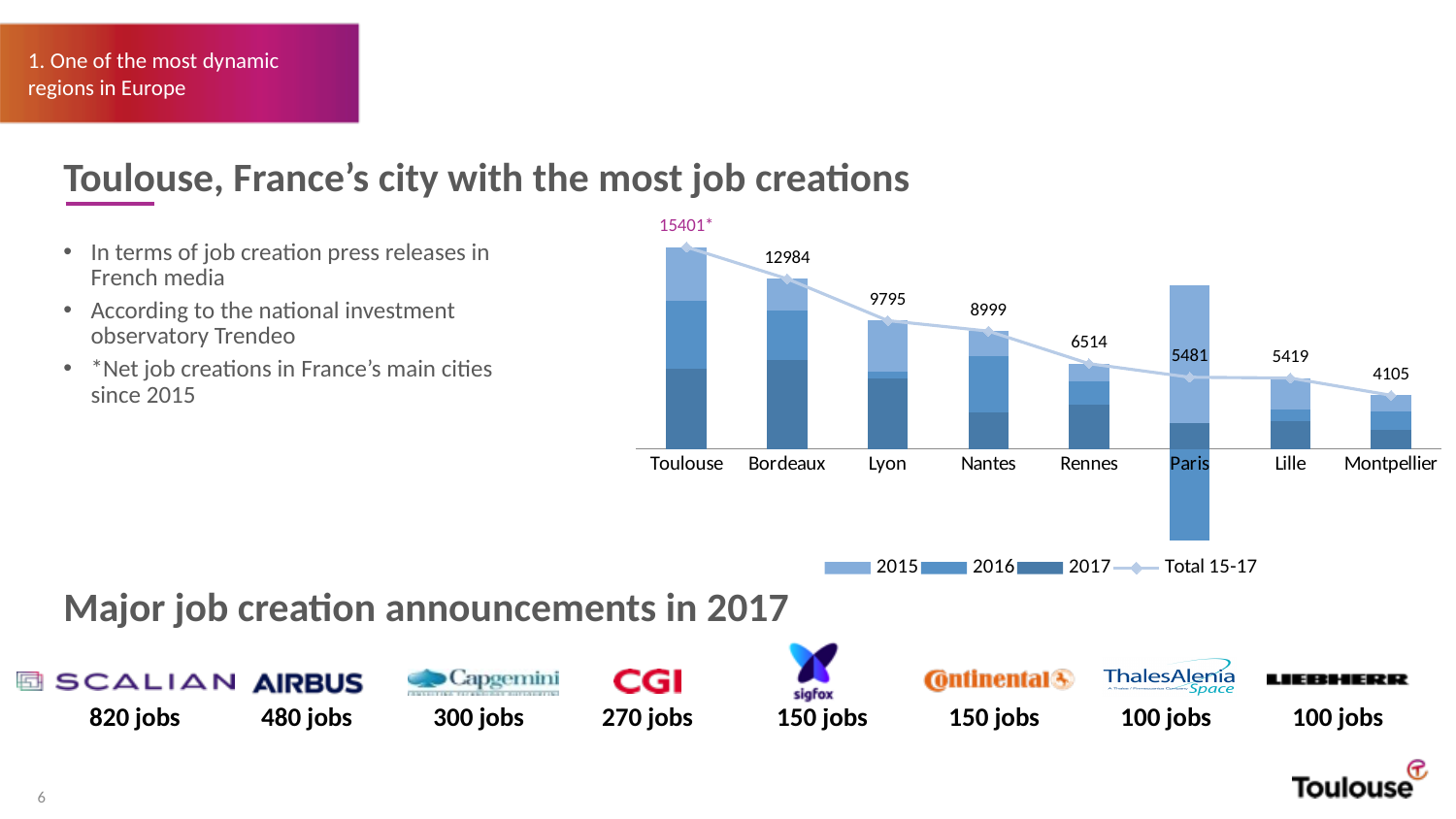
What is the Total 15-17 value shown for Montpellier? 4105 What is the difference between the Total 15-17 values for Toulouse and Bordeaux? 2417 Which city has the lowest Total 15-17 value? Montpellier How many cities are shown on the x axis of the chart? 8 What is the Total 15-17 value shown for Bordeaux? 12984 Which has a larger Total 15-17 value, Lyon or Nantes? Lyon What is the Total 15-17 value shown for Toulouse? 15401* What is the Total 15-17 value shown for Rennes? 6514 Do the Total 15-17 values rise or fall from Toulouse to Montpellier along the x axis? Fall Which city has the highest Total 15-17 value? Toulouse How many series does the chart legend list? 4 What kind of chart is shown on the slide? Stacked bar chart with a line